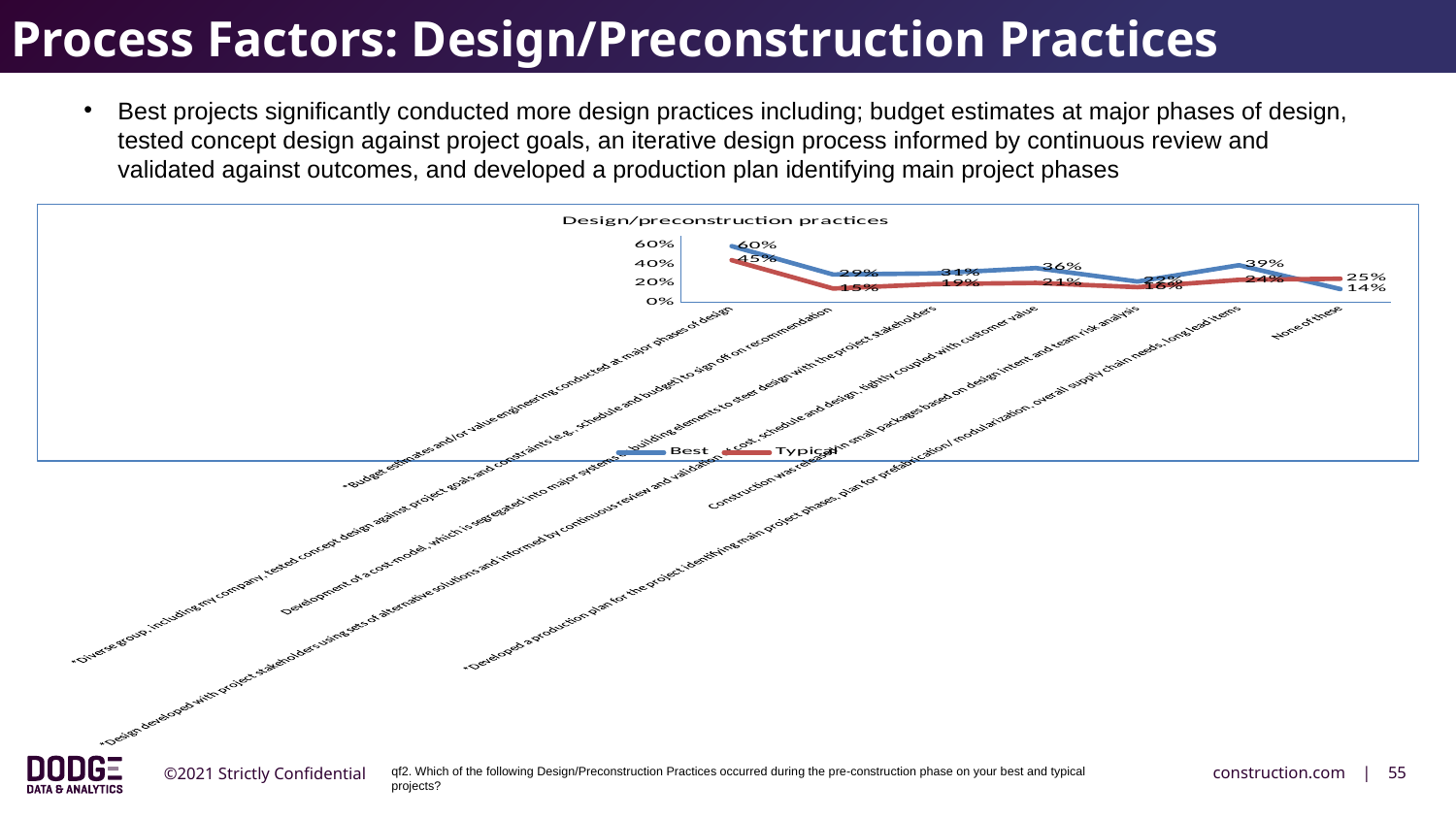
How many series does the legend of the "Design/preconstruction practices" chart list? 2 What is the Best value for "Budget estimates and/or value engineering conducted at major phases of design"? 60% For "None of these", which series has the larger value, Best or Typical? Typical What is the difference between the Best and Typical values for "Budget estimates and/or value engineering conducted at major phases of design"? 15% What is the Best value for "None of these"? 14% Which category has the highest Best value? Budget estimates and/or value engineering conducted at major phases of design What is the Typical value for "None of these"? 25% What type of chart is shown under the title "Design/preconstruction practices"? line chart What are the two series named in the legend of the "Design/preconstruction practices" chart? Best and Typical Which category has the lowest Best value? None of these What is the Typical value for "Budget estimates and/or value engineering conducted at major phases of design"? 45% How many categories are plotted along the x axis of the "Design/preconstruction practices" chart? 7